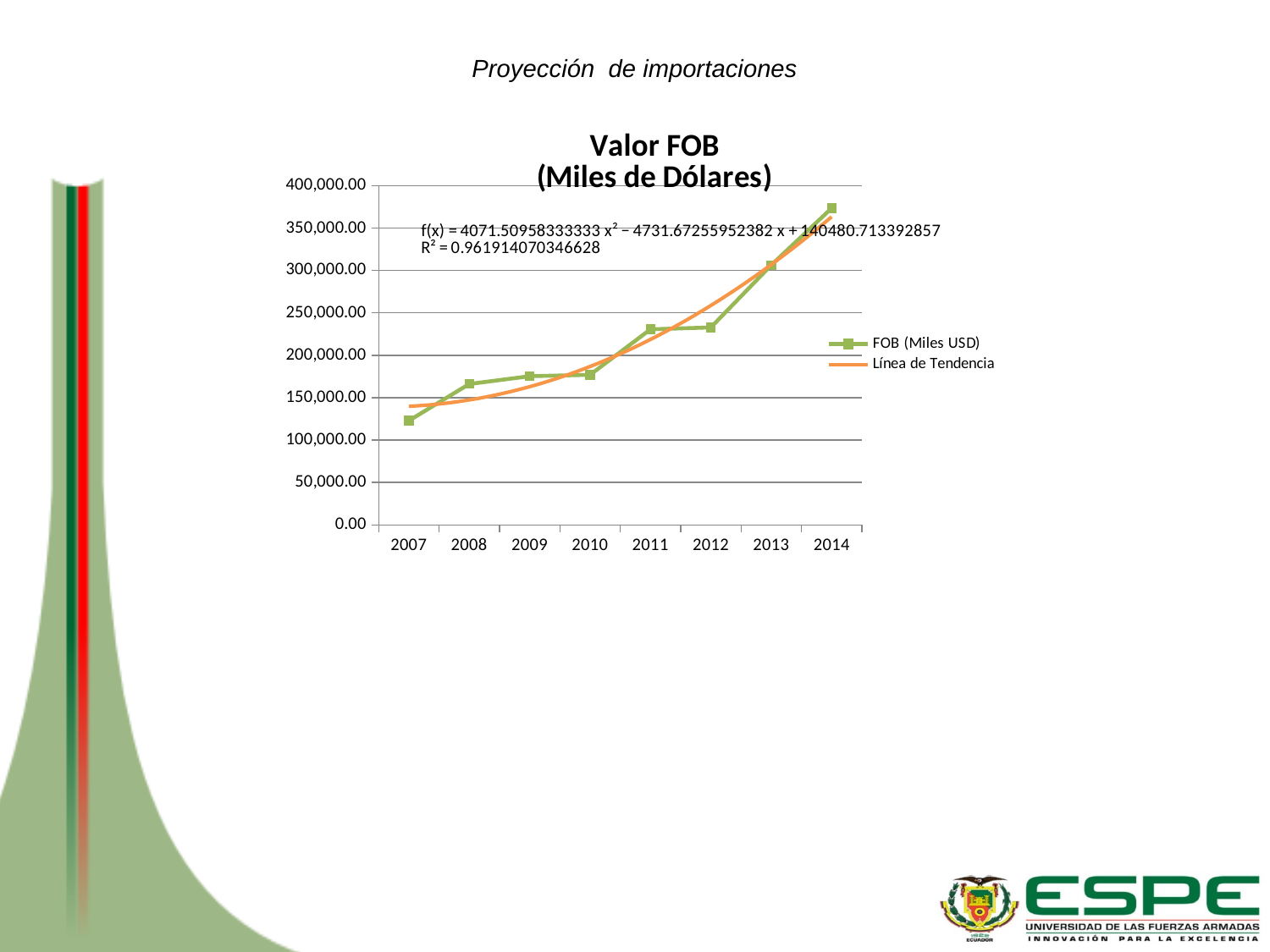
Is the FOB (Miles USD) value for 2007 greater or less than 150,000.00? less Do the FOB (Miles USD) values generally rise or fall from 2007 to 2014? rise Which year has the lowest FOB (Miles USD) value? 2007 How many years are plotted on the x axis? 8 Is the FOB (Miles USD) value for 2011 greater or less than 200,000.00? greater Which year has the larger FOB (Miles USD) value, 2010 or 2013? 2013 What kind of chart is shown on the slide? line chart Is the FOB (Miles USD) value for 2014 greater or less than 350,000.00? greater Which year has the highest FOB (Miles USD) value? 2014 What R² value is printed on the chart for the trend line? 0.961914070346628 How many series does the legend list? 2 What is the title of the chart? Valor FOB (Miles de Dólares)